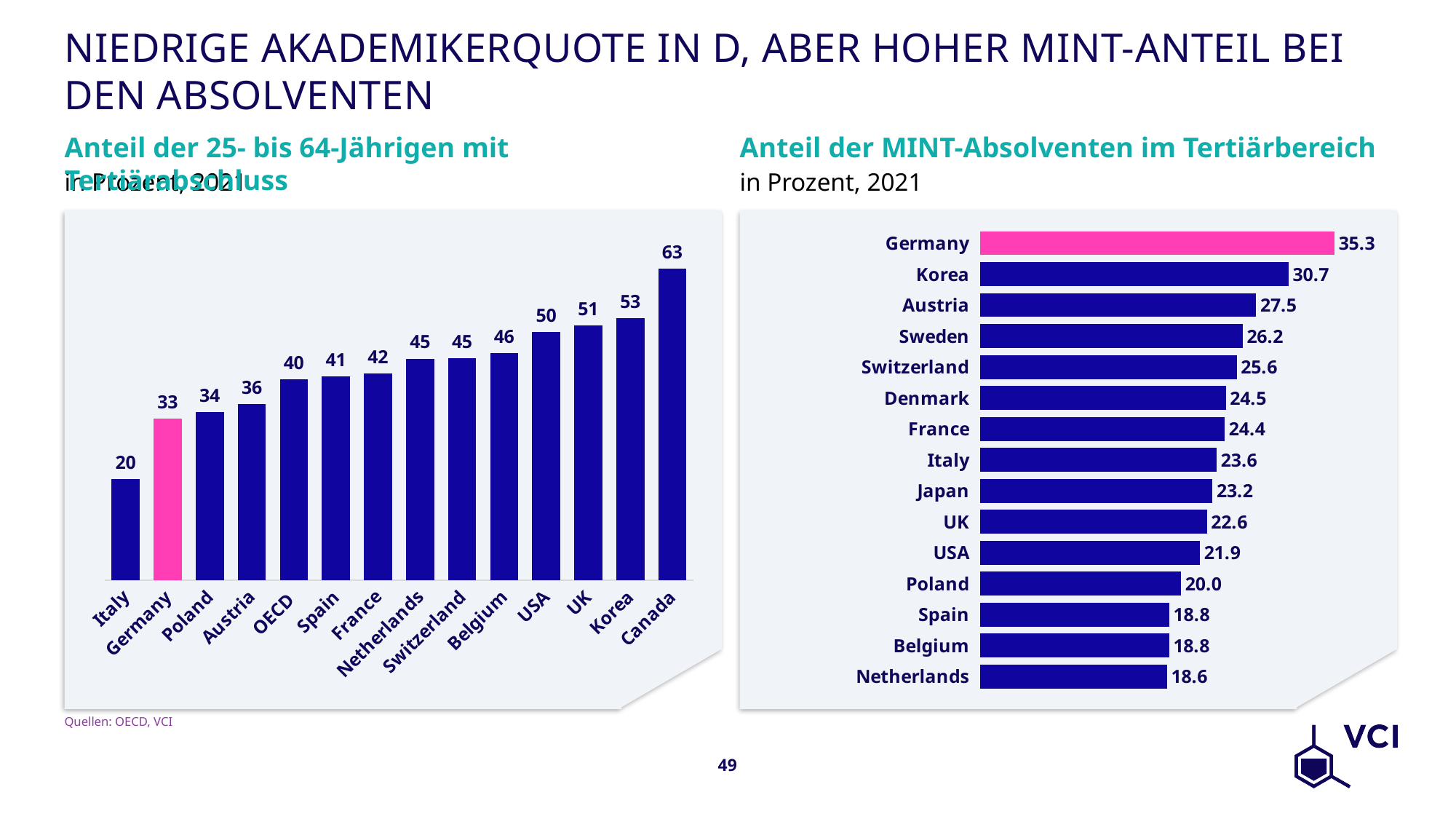
In the left chart, what is the difference between the values for Canada and Italy? 43 In the left chart, what is the value for the OECD? 40 In the left chart, how many bars are shown? 14 In the left chart, which country has the lowest value? Italy In the left chart, which country has the highest share of 25- to 64-year-olds with a tertiary degree? Canada In the right chart, which is larger, the value for Korea or the value for Austria? Korea In the right chart, how many countries are listed? 15 In the right chart, which country has the lowest share of MINT graduates? Netherlands What type of chart is the right chart? Bar chart In the left chart (Anteil der 25- bis 64-Jährigen mit Tertiärabschluss), what is the value for Germany? 33 In the right chart, what is the difference between the values for Germany and Korea? 4.6 In the right chart (Anteil der MINT-Absolventen im Tertiärbereich), what is the value for Germany? 35.3